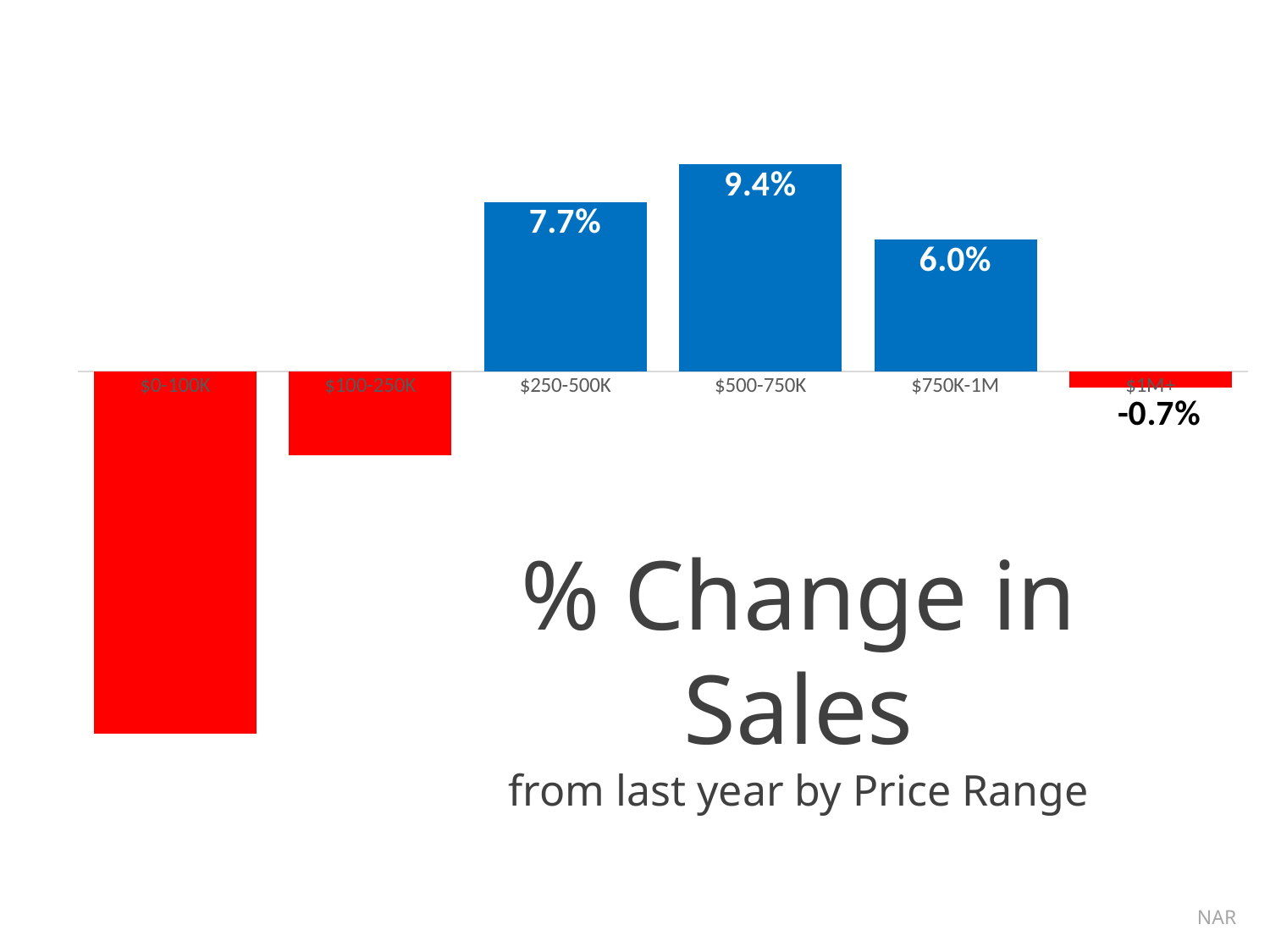
Which price range has the lowest % change in sales? $0-100K What is the difference in % change in sales between the $500-750K and $750K-1M price ranges? 3.4 percentage points What is the % change in sales for the $250-500K price range? 7.7% How many price ranges are shown in the chart? 6 What is the difference in % change in sales between the $500-750K and $250-500K price ranges? 1.7 percentage points What kind of chart is shown on the slide? Bar chart What is the % change in sales for the $500-750K price range? 9.4% Which price range has the highest % change in sales? $500-750K Which price range has a larger % change in sales, $0-100K or $100-250K? $100-250K What colour are the bars for price ranges with a negative % change in sales? Red What is the % change in sales for the $1M+ price range? -0.7% What is the % change in sales for the $750K-1M price range? 6.0%